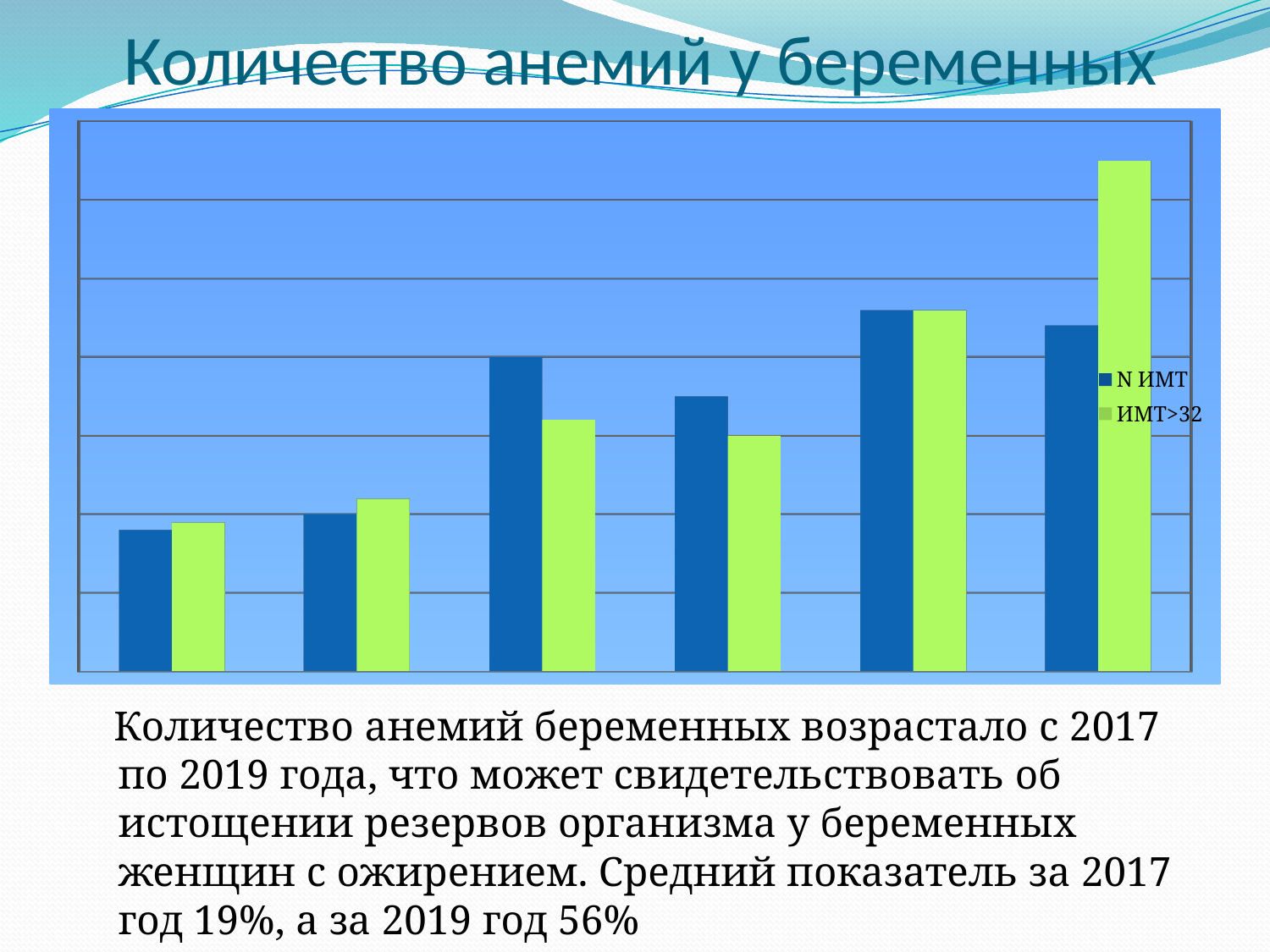
Which group of bars contains the shortest N ИМТ bar? the leftmost (first) group How many groups of bars are plotted in the chart? 6 In the fourth group of bars from the left, which series has the taller bar, N ИМТ or ИМТ>32? N ИМТ Do the ИМТ>32 values generally rise or fall from left to right across the chart? rise What are the two series named in the chart legend? N ИМТ and ИМТ>32 Which group of bars contains the tallest bar in the whole chart? the rightmost (sixth) group How many series does the chart legend list? 2 What kind of chart is shown on the slide? bar chart Which series is drawn in green in the chart? ИМТ>32 In the rightmost group of bars, which series has the taller bar, N ИМТ or ИМТ>32? ИМТ>32 In the third group of bars from the left, which series has the taller bar, N ИМТ or ИМТ>32? N ИМТ Is the tallest bar in the chart a blue (N ИМТ) bar or a green (ИМТ>32) bar? green (ИМТ>32)